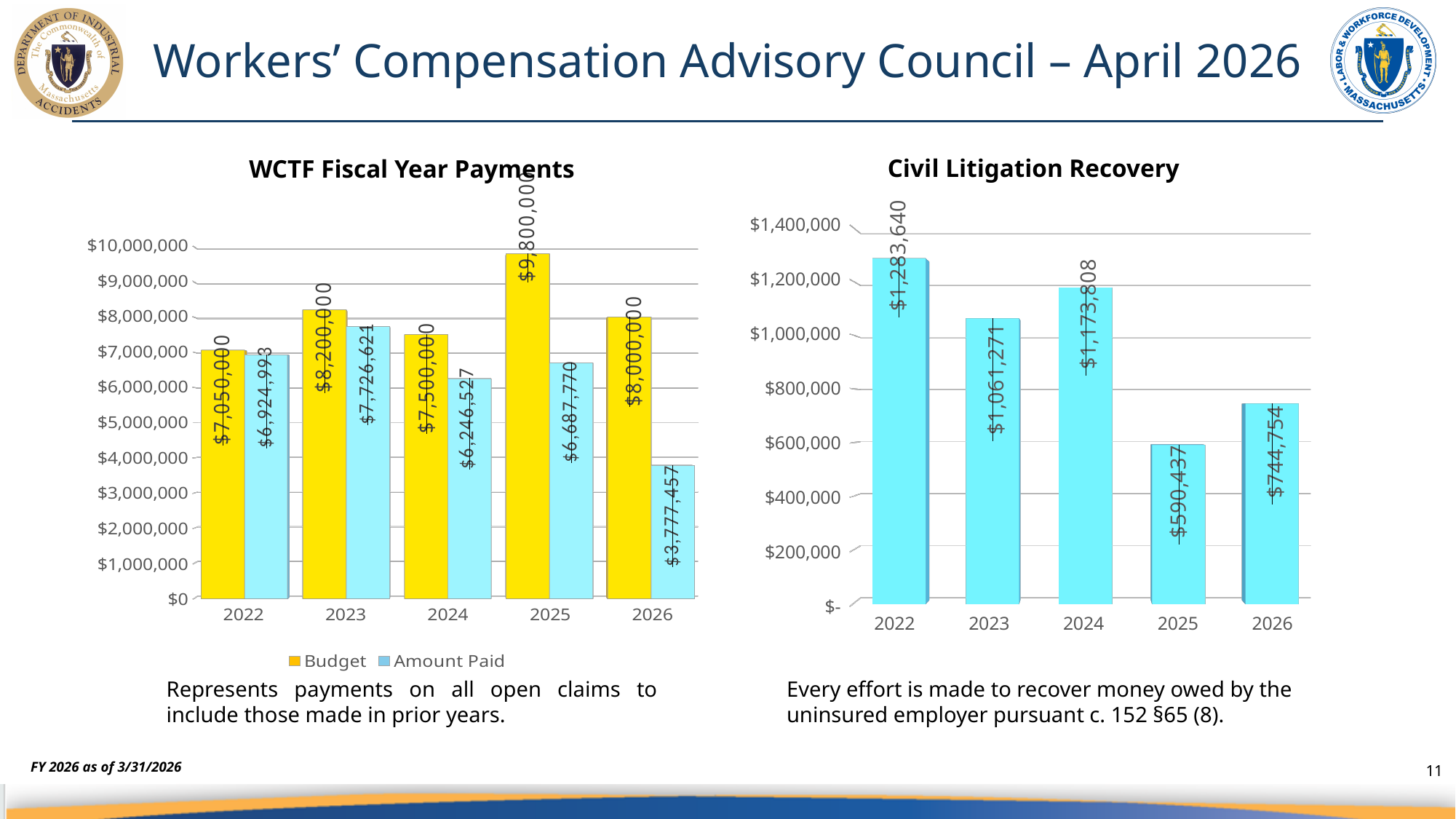
In the Civil Litigation Recovery chart, what is the value for 2023? $1,061,271 What kind of chart is the Civil Litigation Recovery chart? Bar chart In the WCTF Fiscal Year Payments chart, which colour represents the Budget series? Yellow In the WCTF Fiscal Year Payments chart, what is the Amount Paid for 2026? $3,777,457 In the WCTF Fiscal Year Payments chart, which year has the highest Budget? 2025 In the WCTF Fiscal Year Payments chart, what is the Budget value for 2025? $9,800,000 In the WCTF Fiscal Year Payments chart, how many series does the legend list? 2 In the Civil Litigation Recovery chart, which year has the lowest value? 2025 In the WCTF Fiscal Year Payments chart, which year has the lowest Amount Paid? 2026 In the Civil Litigation Recovery chart, which year has the highest value? 2022 In the Civil Litigation Recovery chart, is the value for 2024 larger or smaller than the value for 2023? Larger In the WCTF Fiscal Year Payments chart, what is the difference between the Budget and the Amount Paid for 2024? $1,253,473